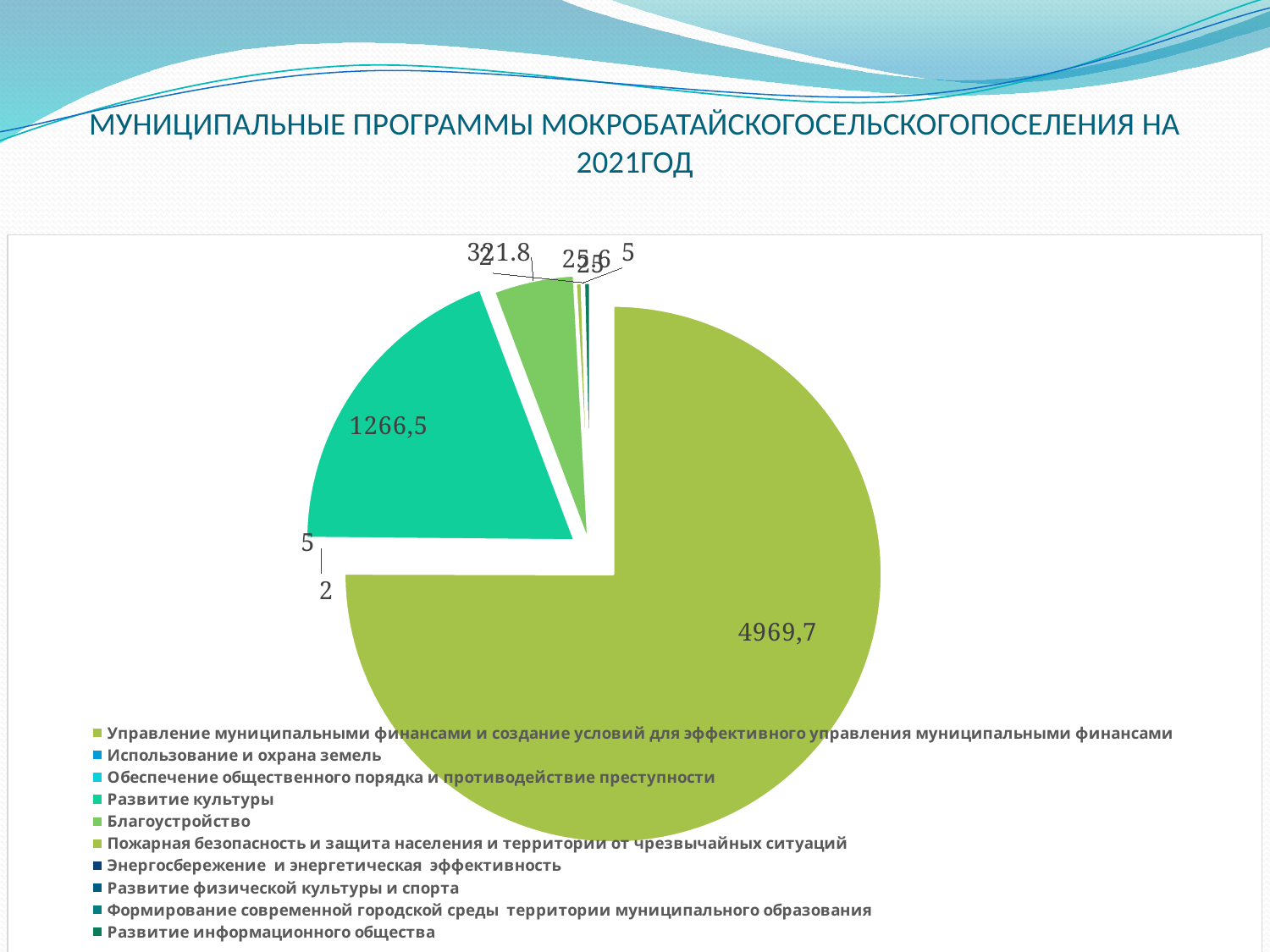
Which category has the second-largest slice of the pie? Развитие культуры What is the difference between the value for Управление муниципальными финансами (4969,7) and the value for Развитие культуры (1266,5)? 3703,2 Which is larger: the value for Управление муниципальными финансами или the value for Развитие культуры? Управление муниципальными финансами What is the title of the slide containing the chart? МУНИЦИПАЛЬНЫЕ ПРОГРАММЫ МОКРОБАТАЙСКОГОСЕЛЬСКОГОПОСЕЛЕНИЯ НА 2021ГОД Which legend entry is listed last in the chart's legend? Развитие информационного общества What is the value shown for Развитие культуры? 1266,5 Which category has the largest slice of the pie? Управление муниципальными финансами и создание условий для эффективного управления муниципальными финансами What kind of chart is shown on the slide? pie chart How many categories does the chart's legend list? 10 What is the value shown for the largest slice of the pie? 4969,7